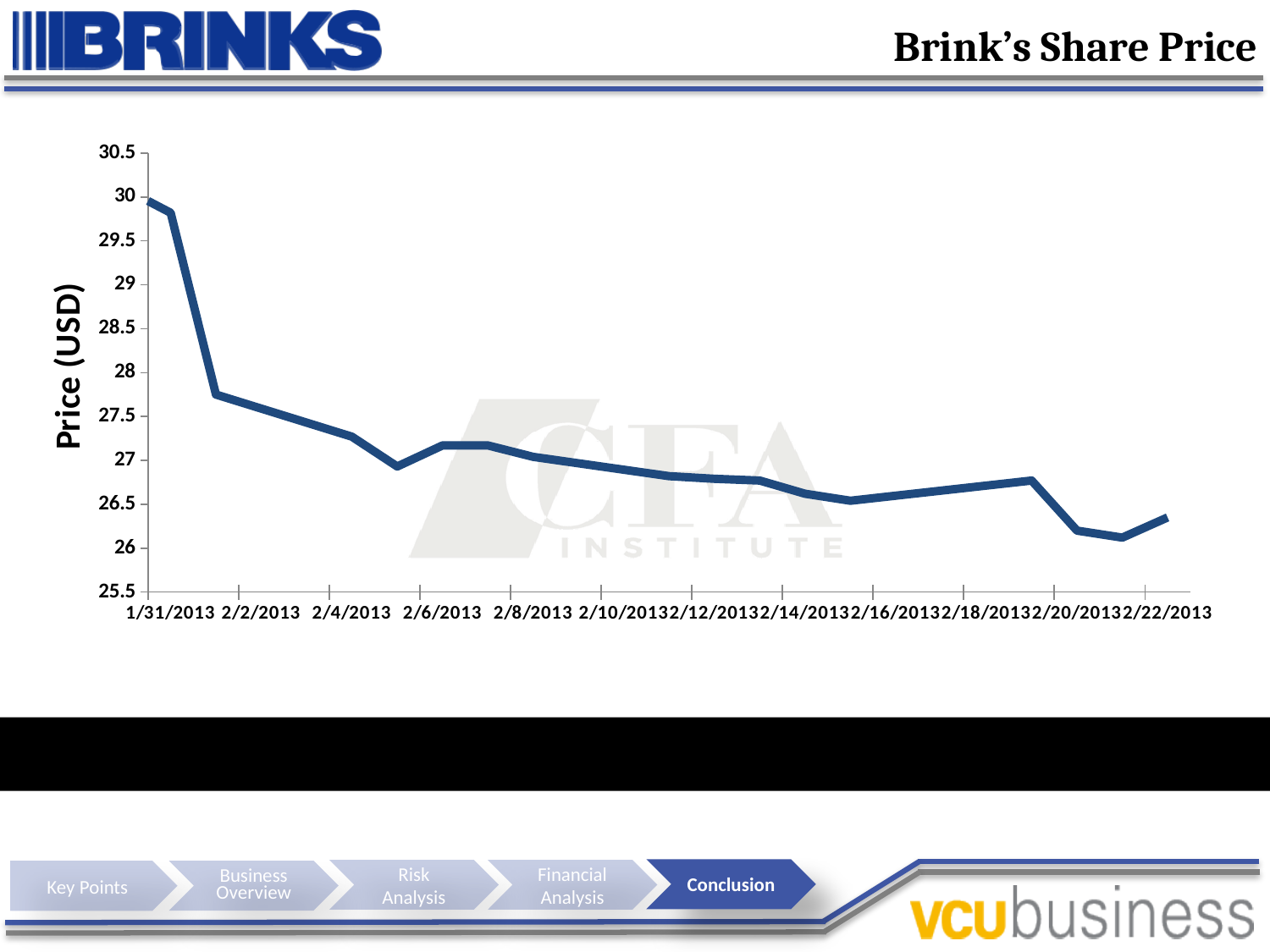
Is the share price on 2/6/2013 greater or less than 27? greater What kind of chart is shown on the slide? line chart How many date labels are shown on the horizontal axis? 12 What is the title of the chart? Brink's Share Price Which date has the higher share price, 2/2/2013 or 2/20/2013? 2/2/2013 What is the label on the vertical axis of the chart? Price (USD) Is the share price on 1/31/2013 greater or less than 29.5? greater Is the share price on 2/16/2013 greater or less than 27? less On which date is the share price highest? 1/31/2013 Overall, does the share price rise or fall from 1/31/2013 to 2/22/2013? fall